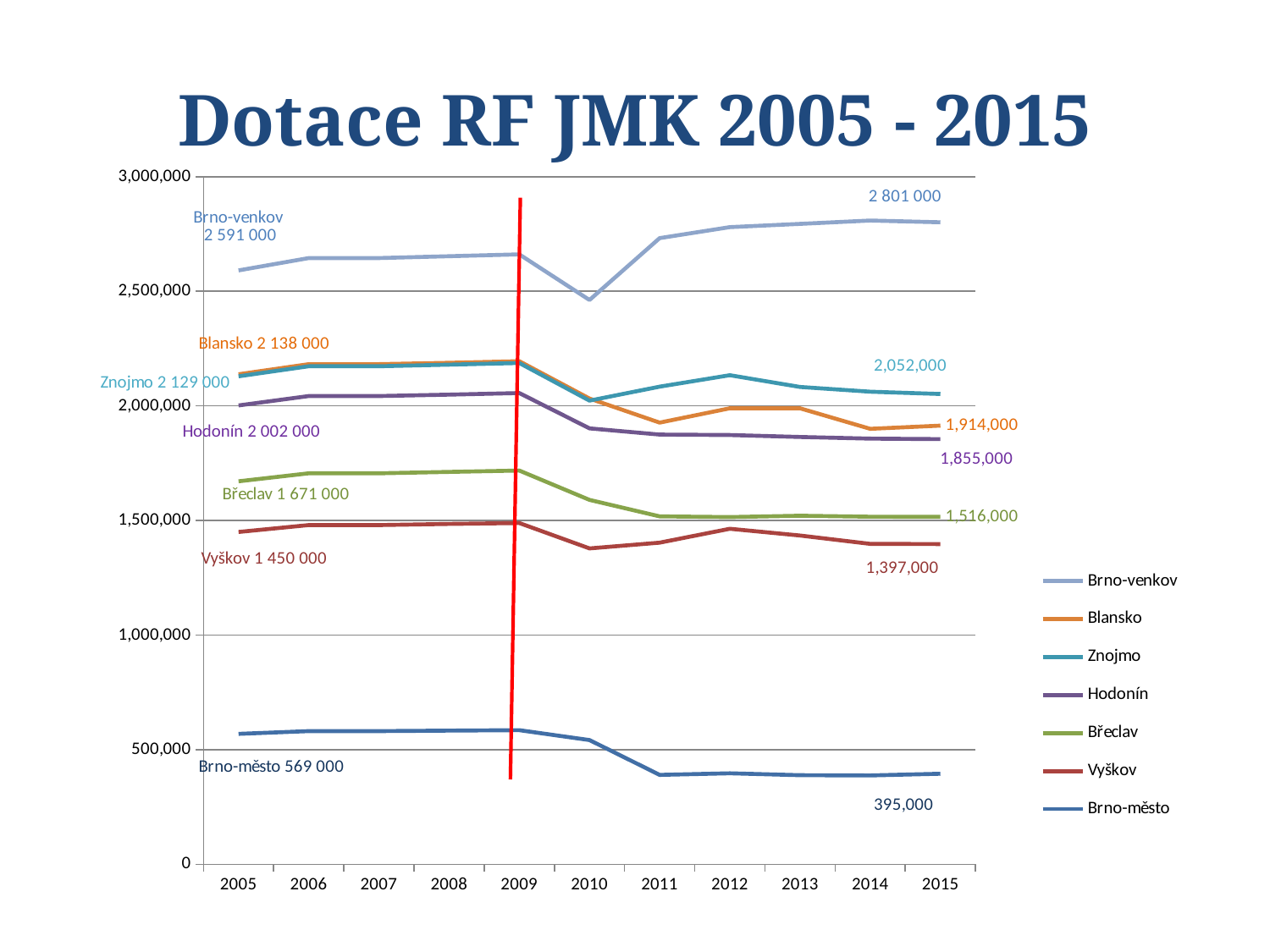
Which is larger in 2015: the value for Blansko or the value for Znojmo? Znojmo By how much did the value for Brno-venkov change from 2005 (2 591 000) to 2015 (2 801 000)? 210,000 Does the value for Brno-město rise or fall from 2009 to 2011? fall How many series does the legend list? 7 What is the value for Brno-venkov in 2005? 2 591 000 How many years are shown on the x axis? 11 Which series has the highest value in 2015? Brno-venkov Which series has the lowest value in 2005? Brno-město What is the value for Brno-město in 2005? 569 000 What is the value for Vyškov in 2015? 1,397,000 What type of chart is shown on the slide? line chart What is the value for Brno-venkov in 2015? 2 801 000